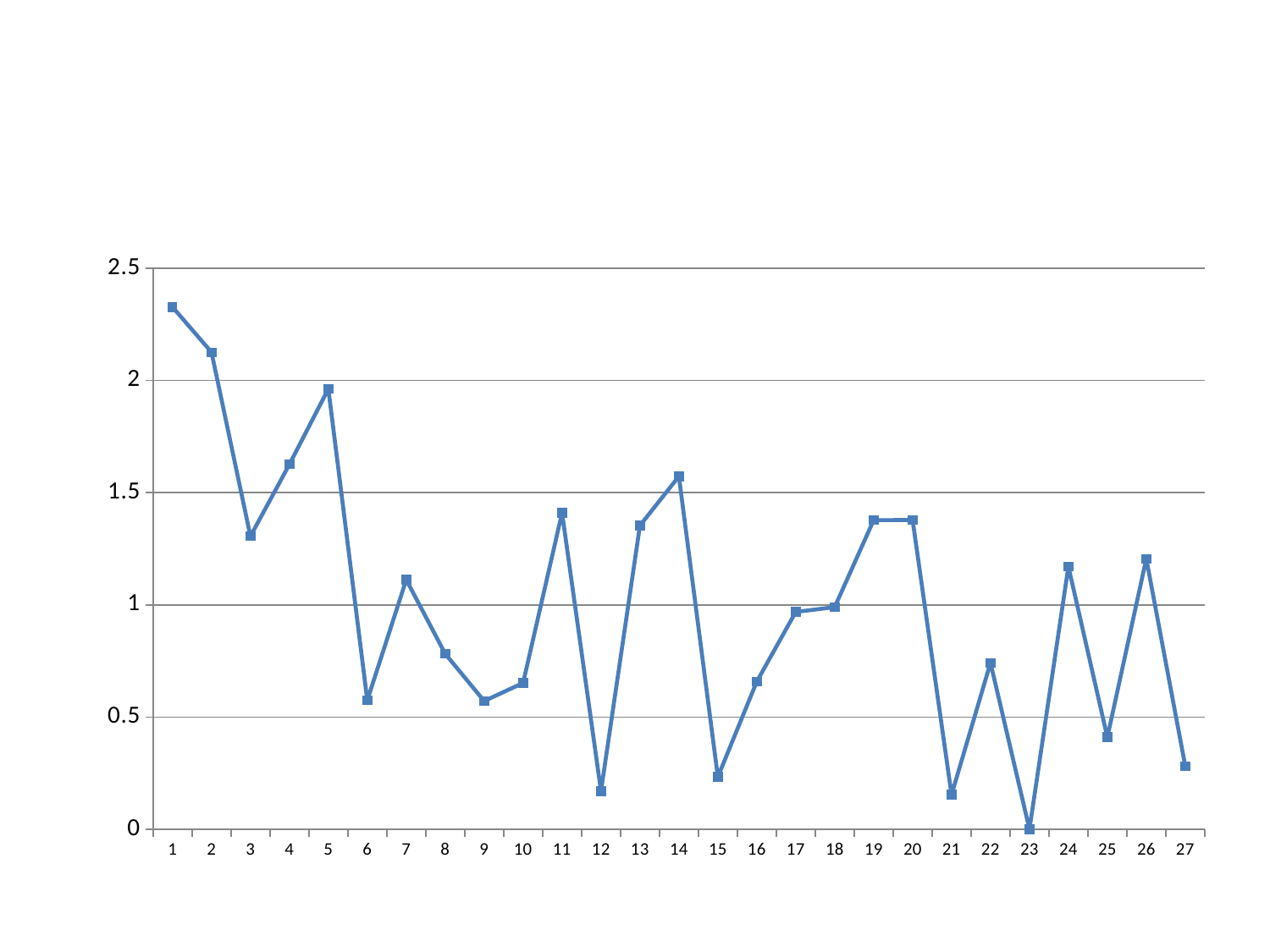
Is the value for category 1 greater or less than 2? greater Which has the larger value, category 2 or category 3? 2 What is the value at category 23? 0 What kind of chart is shown on the slide? line chart Is the value for category 12 greater or less than 0.5? less Is the value for category 14 greater or less than 1.5? greater How many data points are plotted on the chart? 27 Which x-axis category has the lowest value? 23 Which has the larger value, category 11 or category 12? 11 Overall, do the values tend to rise or fall from category 1 to category 27? fall Which x-axis category has the highest value? 1